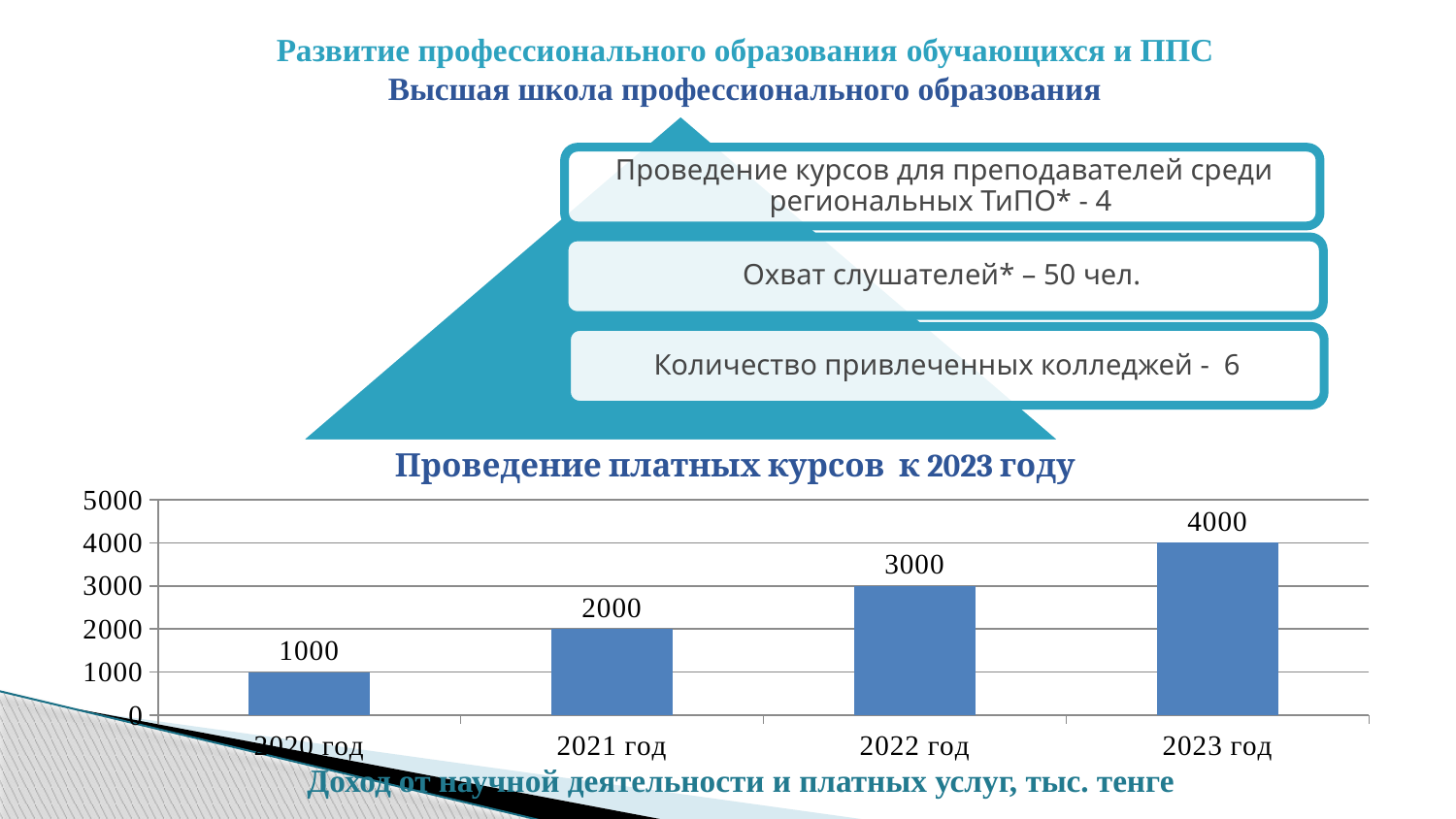
Is the value for 2022 год greater or less than 2000? greater What is the value for 2023 год? 4000 Do the values rise or fall from 2020 год to 2023 год? rise What is the difference between the values for 2023 год and 2021 год? 2000 What is the title of the chart? Проведение платных курсов к 2023 году What is the value for 2021 год? 2000 Which is larger, the value for 2022 год or the value for 2021 год? 2022 год What kind of chart is shown? bar chart How many years are shown on the x axis? 4 Which year has the lowest value? 2020 год What is the value for 2020 год? 1000 Which year has the highest value? 2023 год